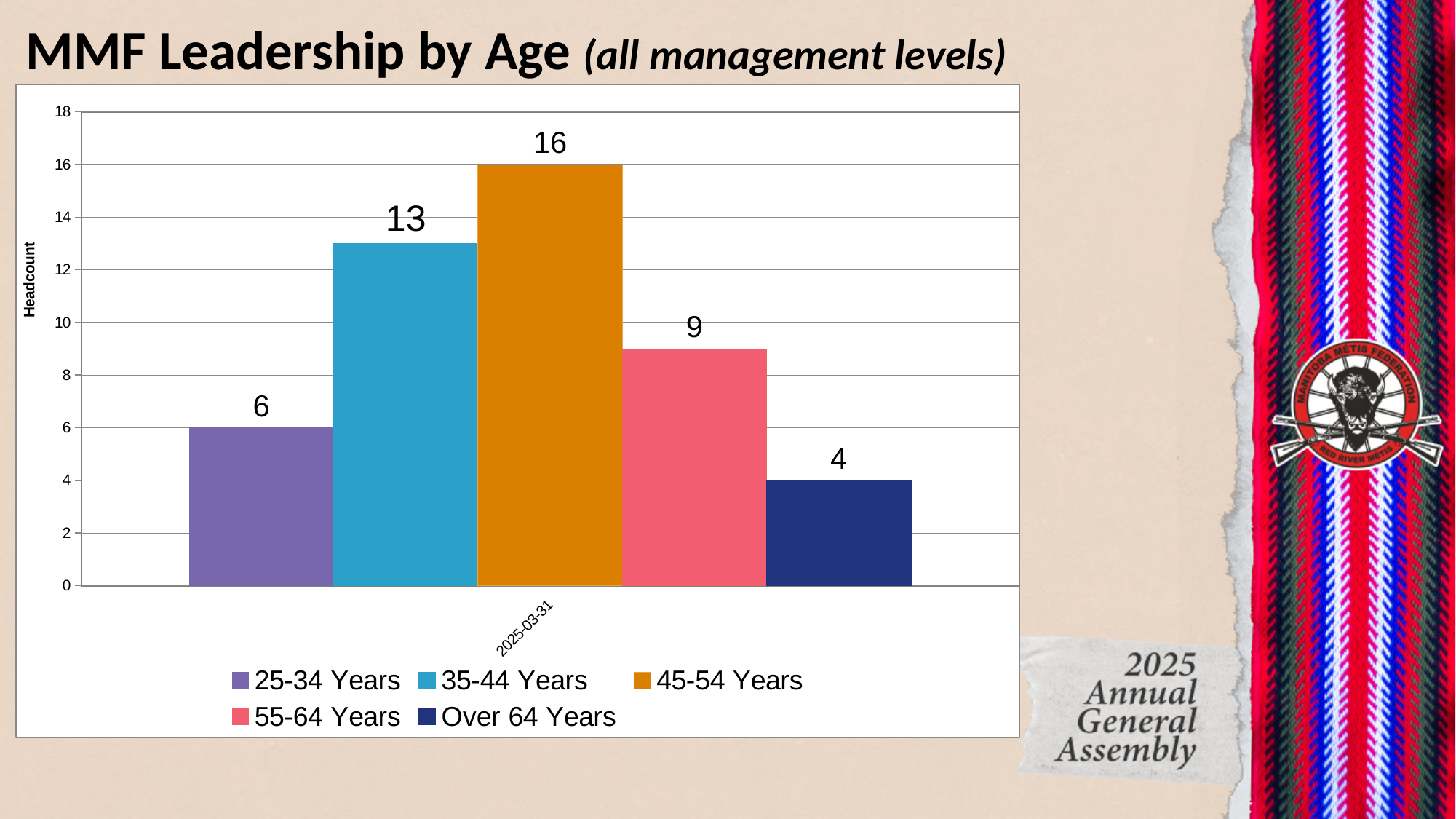
What is the difference in headcount between the 55-64 Years and Over 64 Years groups? 5 What is the headcount for the 25-34 Years age group? 6 Which age group has the lowest headcount? Over 64 Years What is the label on the vertical axis of the chart? Headcount Which age group has the highest headcount? 45-54 Years What is the difference in headcount between the 45-54 Years and 35-44 Years groups? 3 What is the headcount for the Over 64 Years age group? 4 What kind of chart is shown on the slide? Bar chart What is the headcount for the 45-54 Years age group? 16 How many age groups does the legend list? 5 What date is shown on the horizontal axis of the chart? 2025-03-31 Which has a larger headcount, 35-44 Years or 55-64 Years? 35-44 Years